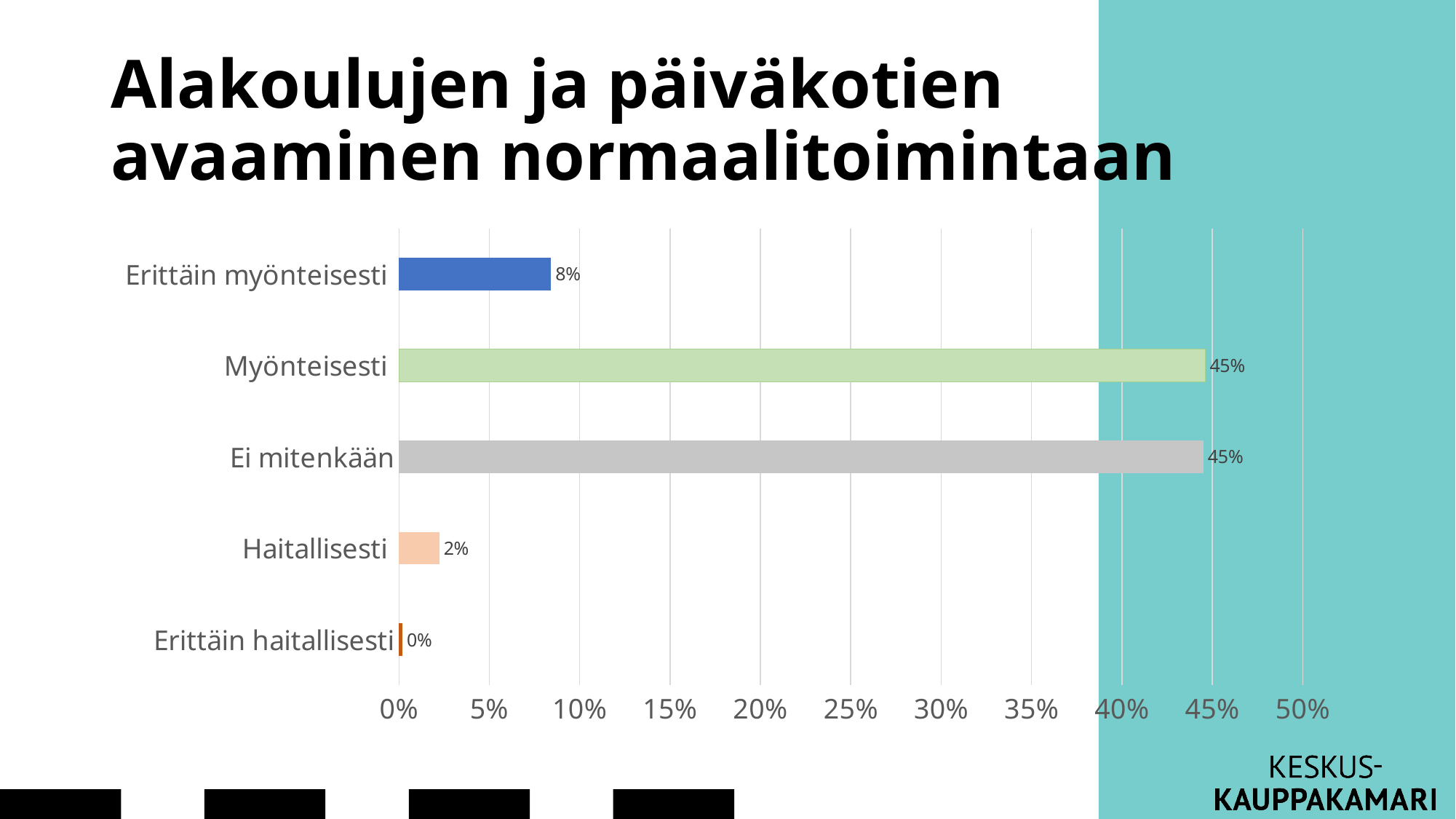
How many categories are shown in the chart? 5 What is the difference between the values for Ei mitenkään and Erittäin myönteisesti? 37% Which is larger, the value for Erittäin myönteisesti or the value for Haitallisesti? Erittäin myönteisesti What is the value for Myönteisesti? 45% Is the value for Ei mitenkään greater or less than 40%? greater What is the value for Erittäin myönteisesti? 8% What is the value for Haitallisesti? 2% What is the value for Erittäin haitallisesti? 0% What is the title of the slide? Alakoulujen ja päiväkotien avaaminen normaalitoimintaan What kind of chart is shown on the slide? bar chart Which category has the lowest value? Erittäin haitallisesti What is the difference between the values for Erittäin myönteisesti and Haitallisesti? 6%